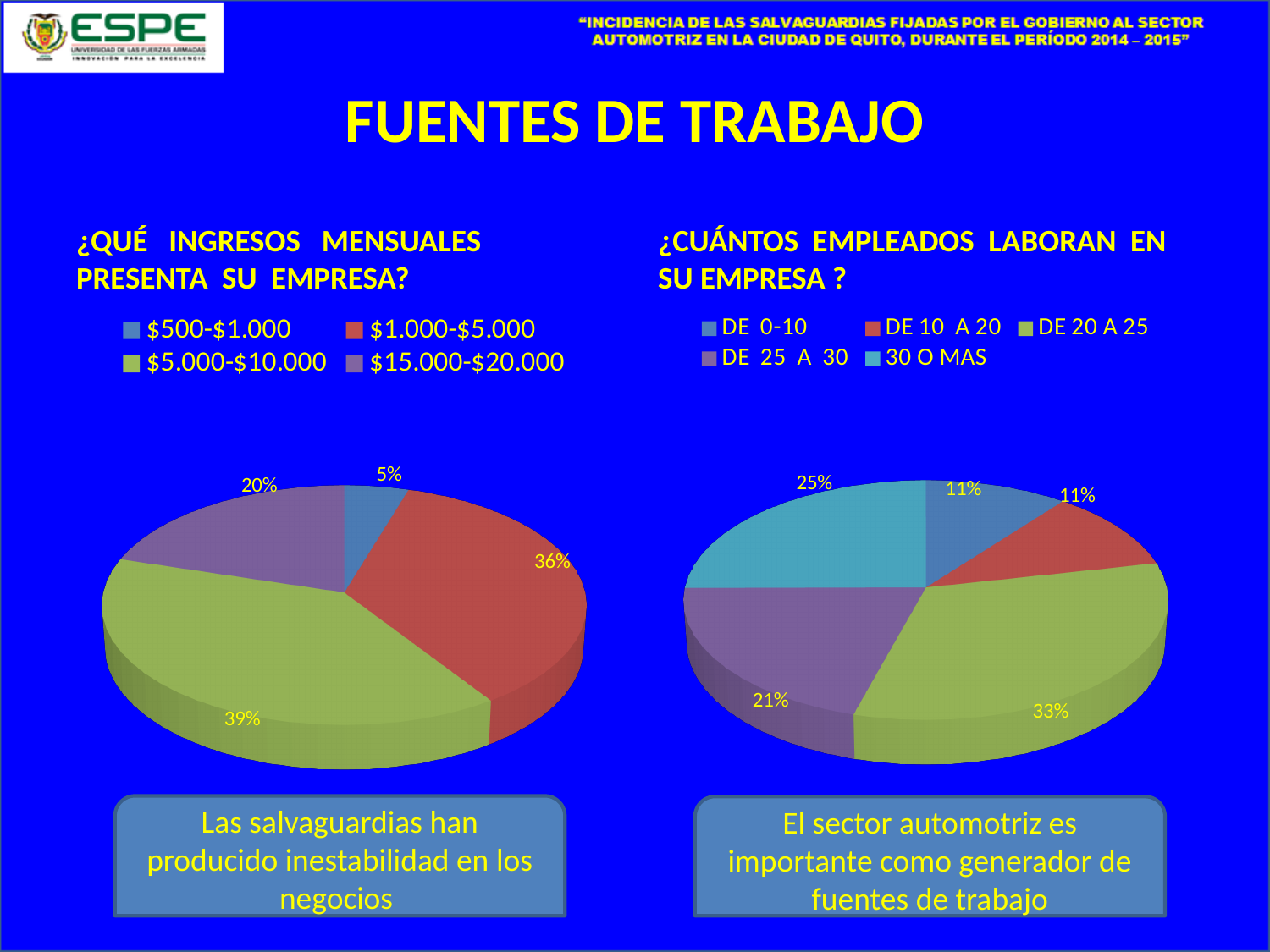
In the right pie chart (¿CUÁNTOS EMPLEADOS LABORAN EN SU EMPRESA?), what share is shown for DE 20 A 25? 33% How many categories does the legend of the left pie chart (¿QUÉ INGRESOS MENSUALES PRESENTA SU EMPRESA?) list? 4 In the right pie chart (¿CUÁNTOS EMPLEADOS LABORAN EN SU EMPRESA?), what share is shown for 30 O MAS? 25% In the left pie chart (¿QUÉ INGRESOS MENSUALES PRESENTA SU EMPRESA?), which category has the smallest share? $500-$1.000 How many categories does the legend of the right pie chart (¿CUÁNTOS EMPLEADOS LABORAN EN SU EMPRESA?) list? 5 In the left pie chart (¿QUÉ INGRESOS MENSUALES PRESENTA SU EMPRESA?), which category has the largest share? $5.000-$10.000 What type of chart is used for the right chart (¿CUÁNTOS EMPLEADOS LABORAN EN SU EMPRESA?)? Pie chart In the left pie chart (¿QUÉ INGRESOS MENSUALES PRESENTA SU EMPRESA?), what share is shown for $500-$1.000? 5% In the right pie chart (¿CUÁNTOS EMPLEADOS LABORAN EN SU EMPRESA?), which category has the largest share? DE 20 A 25 In the left pie chart (¿QUÉ INGRESOS MENSUALES PRESENTA SU EMPRESA?), what share is shown for $5.000-$10.000? 39% In the left pie chart (¿QUÉ INGRESOS MENSUALES PRESENTA SU EMPRESA?), what is the difference between the shares for $1.000-$5.000 and $15.000-$20.000? 16% In the right pie chart (¿CUÁNTOS EMPLEADOS LABORAN EN SU EMPRESA?), which is larger, the share for DE 25 A 30 or the share for 30 O MAS? 30 O MAS